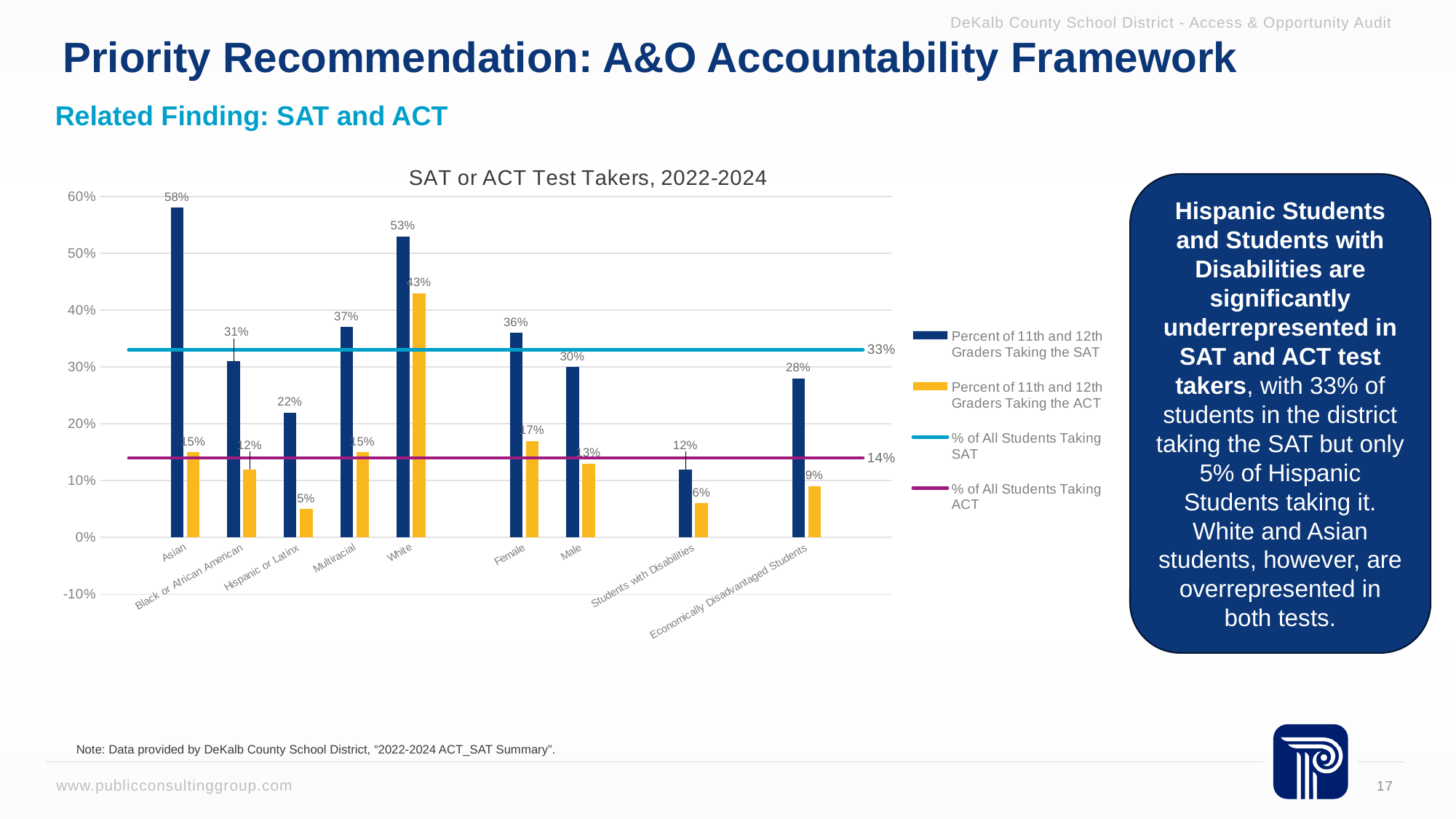
What kind of chart is used to show the SAT and ACT test taker percentages? Bar chart Which is larger: the percent of Female students taking the SAT or the percent of Male students taking the SAT? Female What percent of 11th and 12th grade Asian students are shown taking the SAT? 58% How many series does the legend list? 4 Which category has the lowest percent of 11th and 12th graders taking the ACT? Hispanic or Latinx How many categories are shown on the x axis of the chart? 9 What percent of 11th and 12th grade White students are shown taking the ACT? 43% Which category has the highest percent of 11th and 12th graders taking the SAT? Asian What percent of 11th and 12th grade Hispanic or Latinx students are shown taking the ACT? 5% What is the value of the '% of All Students Taking SAT' line? 33% What is the title of the chart? SAT or ACT Test Takers, 2022-2024 What is the difference between the SAT and ACT percentages for Students with Disabilities? 6%